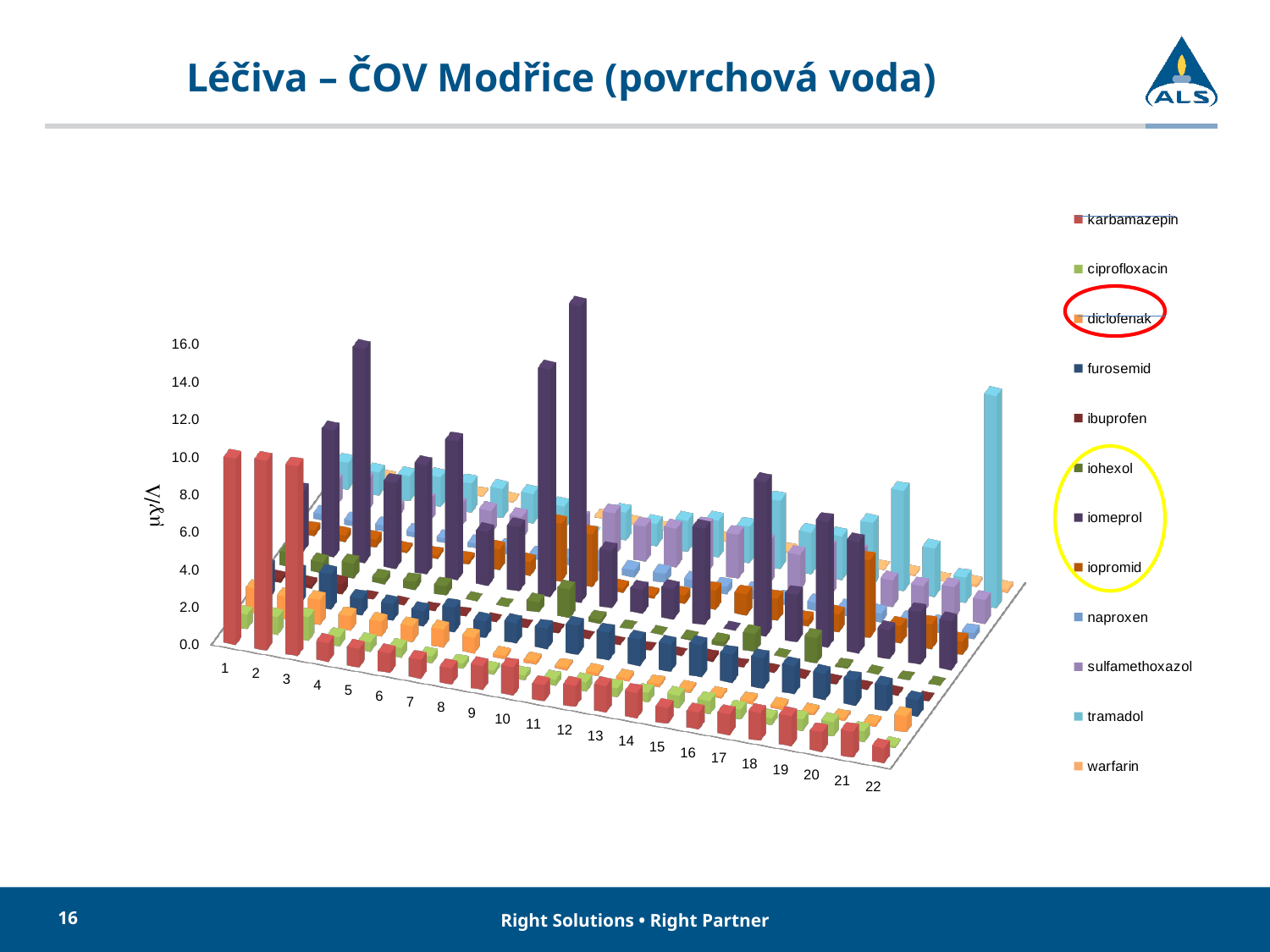
What kind of chart is shown on the slide? bar chart At which category does the iomeprol series reach its highest value? 10 What unit is shown on the vertical axis of the chart? µg/l Is the value for iomeprol at category 12 greater or less than 10.0? less Is the value for karbamazepin at category 1 greater or less than 4.0? greater What is the highest tick value shown on the vertical axis? 16.0 What is the title of the slide containing the chart? Léčiva – ČOV Modřice (povrchová voda) Which series has the tallest bar in the chart? iomeprol How many series does the legend list? 12 Is the value for tramadol at category 22 greater or less than 8.0? greater Which is larger, the iomeprol value at category 12 or the iomeprol value at category 1? category 1 How many categories are shown along the x axis? 22